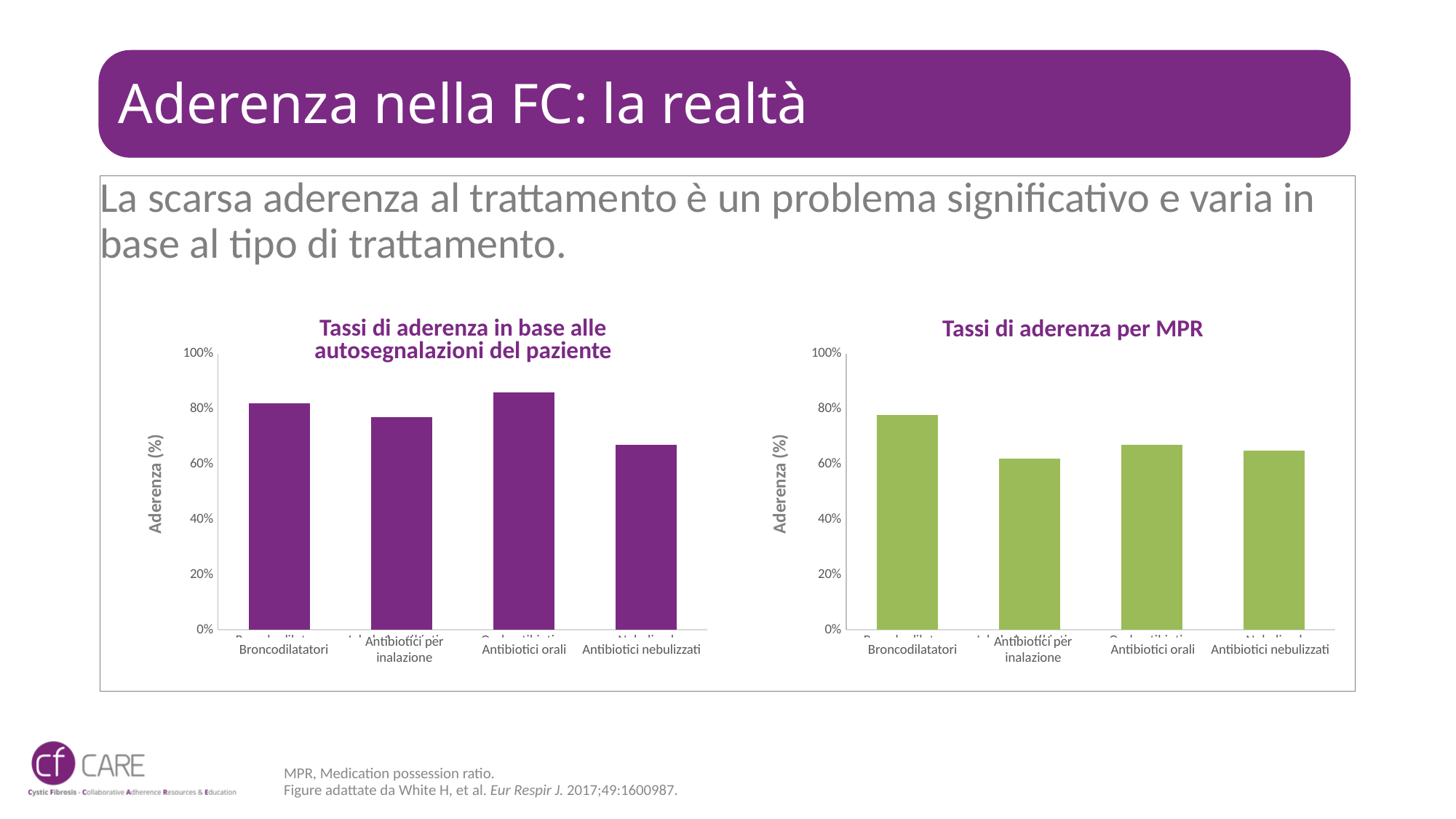
How many categories are shown on the x axis of the chart titled "Tassi di aderenza in base alle autosegnalazioni del paziente"? 4 In the chart titled "Tassi di aderenza in base alle autosegnalazioni del paziente", which category has the lowest adherence? Antibiotici nebulizzati In the chart titled "Tassi di aderenza in base alle autosegnalazioni del paziente", which category has the highest adherence? Antibiotici orali In the chart titled "Tassi di aderenza in base alle autosegnalazioni del paziente", is the value for Antibiotici nebulizzati greater or less than 80%? less What kind of chart is the chart titled "Tassi di aderenza per MPR"? bar chart What is the y-axis label of the chart on the right of the slide? Aderenza (%) In the chart titled "Tassi di aderenza per MPR", is the value for Antibiotici per inalazione greater or less than 80%? less In the chart titled "Tassi di aderenza in base alle autosegnalazioni del paziente", is the value for Broncodilatatori greater or less than 80%? greater In the chart titled "Tassi di aderenza per MPR", which is larger: the value for Broncodilatatori or the value for Antibiotici orali? Broncodilatatori In the chart titled "Tassi di aderenza in base alle autosegnalazioni del paziente", which is larger: the value for Antibiotici per inalazione or the value for Antibiotici nebulizzati? Antibiotici per inalazione In the chart titled "Tassi di aderenza per MPR", which category has the highest adherence? Broncodilatatori